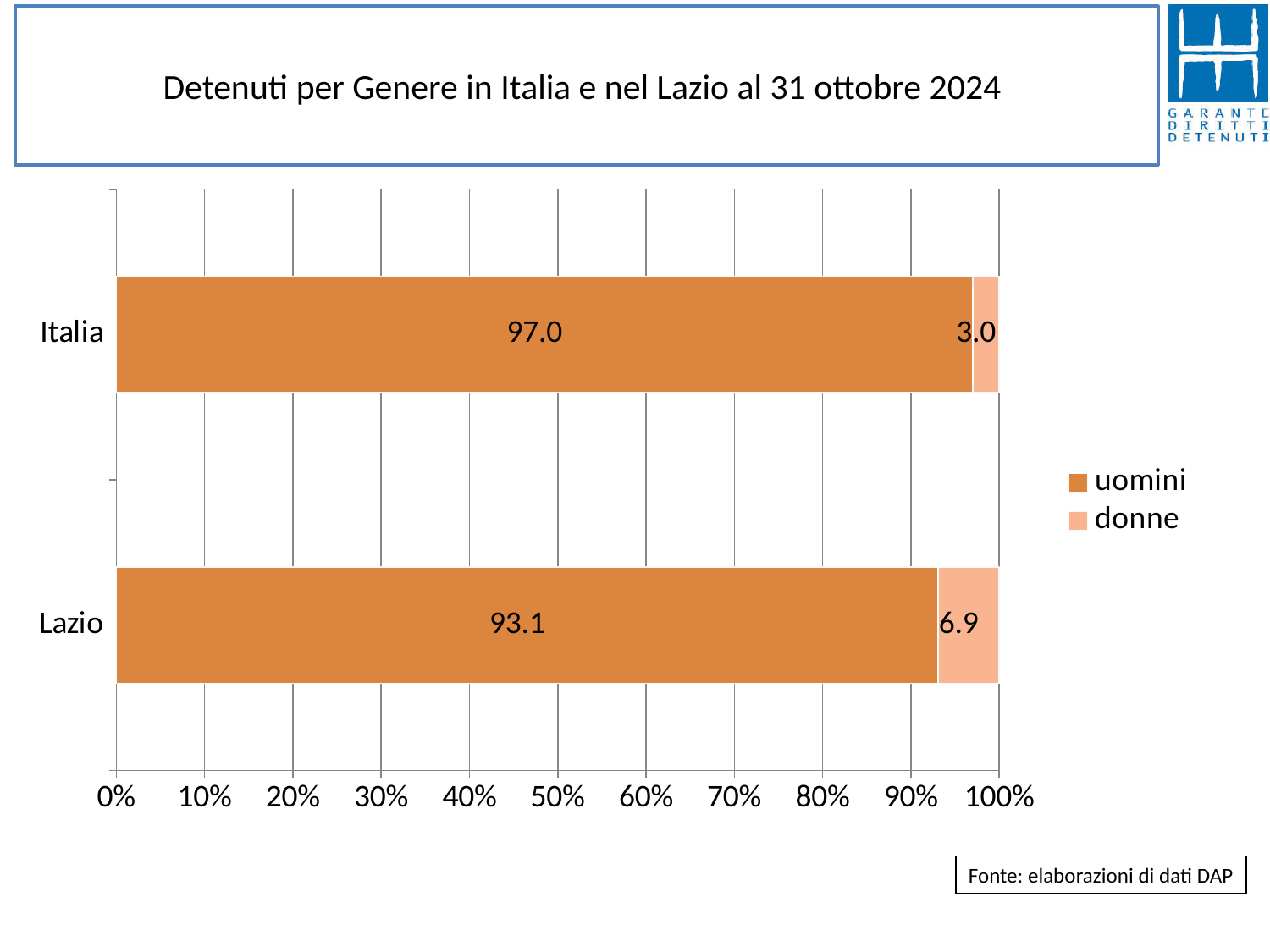
Which category has the highest value for uomini? Italia What is the difference between the uomini values for Italia and Lazio? 3.9 What is the value for uomini in Italia? 97.0 What is the difference between the donne values for Lazio and Italia? 3.9 How many categories are shown on the chart? 2 What kind of chart is shown on the slide? Stacked bar chart What is the value for donne in Lazio? 6.9 What is the value for uomini in Lazio? 93.1 What is the title of the chart? Detenuti per Genere in Italia e nel Lazio al 31 ottobre 2024 What is the value for donne in Italia? 3.0 How many series does the legend list? 2 Which category has the higher value for donne, Italia or Lazio? Lazio